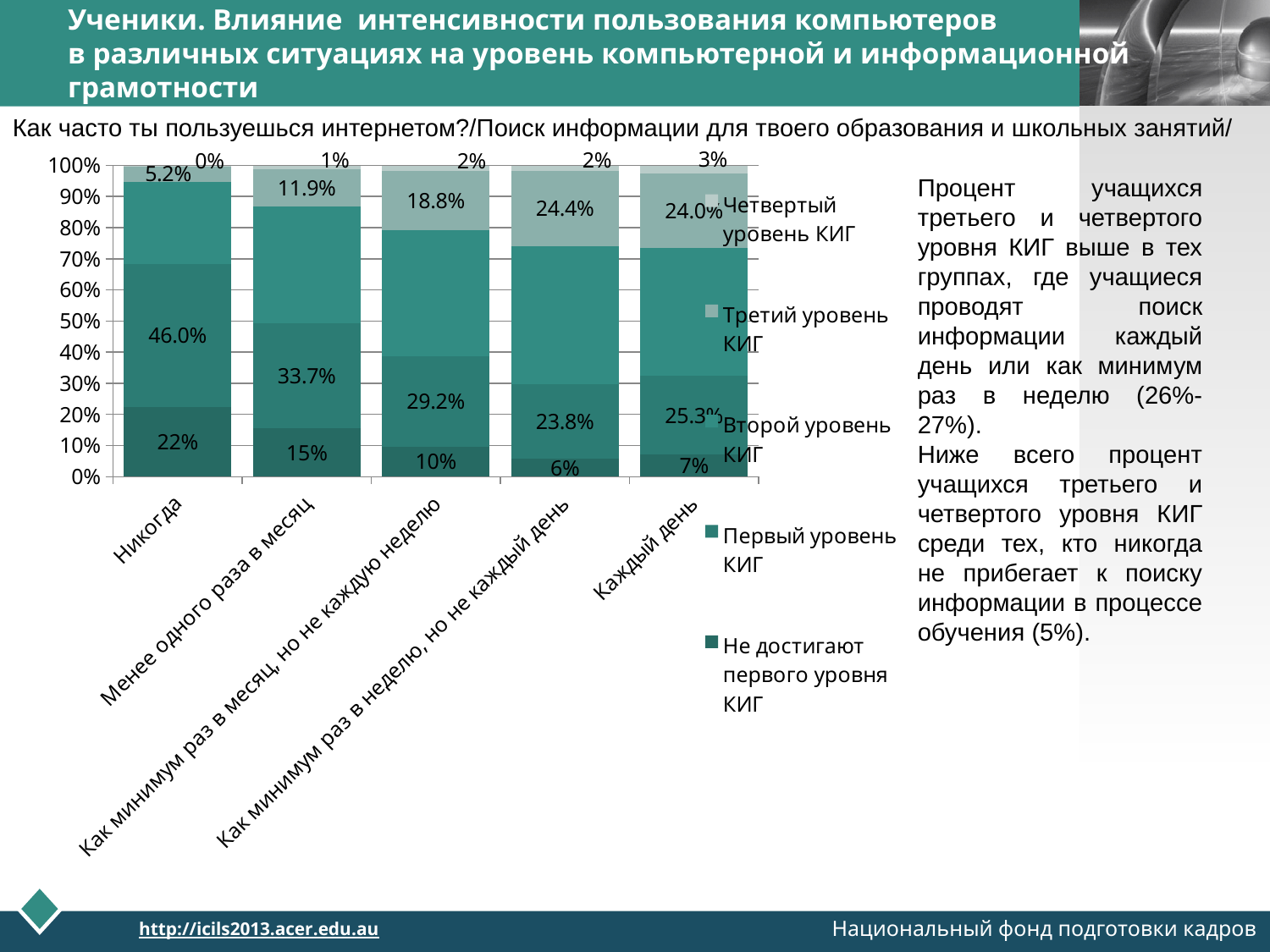
What is the value of 'Не достигают первого уровня КИГ' for the category 'Никогда'? 22% What is the value of 'Третий уровень КИГ' for the category 'Каждый день'? 24.0% Which category has the lowest value for 'Не достигают первого уровня КИГ'? Как минимум раз в неделю, но не каждый день How many categories (frequency groups) are shown on the x axis of the chart? 5 What is the value of 'Первый уровень КИГ' for the category 'Как минимум раз в месяц, но не каждую неделю'? 29.2% Which category has the larger 'Третий уровень КИГ' value: 'Никогда' or 'Менее одного раза в месяц'? Менее одного раза в месяц How many series does the chart legend list? 5 Which series is listed first (at the top) in the chart legend? Четвертый уровень КИГ What kind of chart is shown on the slide? Stacked bar chart What is the difference between the 'Первый уровень КИГ' values for 'Никогда' and 'Каждый день'? 20.7 percentage points Which category has the highest value for 'Третий уровень КИГ'? Как минимум раз в неделю, но не каждый день What is the value of 'Четвертый уровень КИГ' for the category 'Каждый день'? 3%